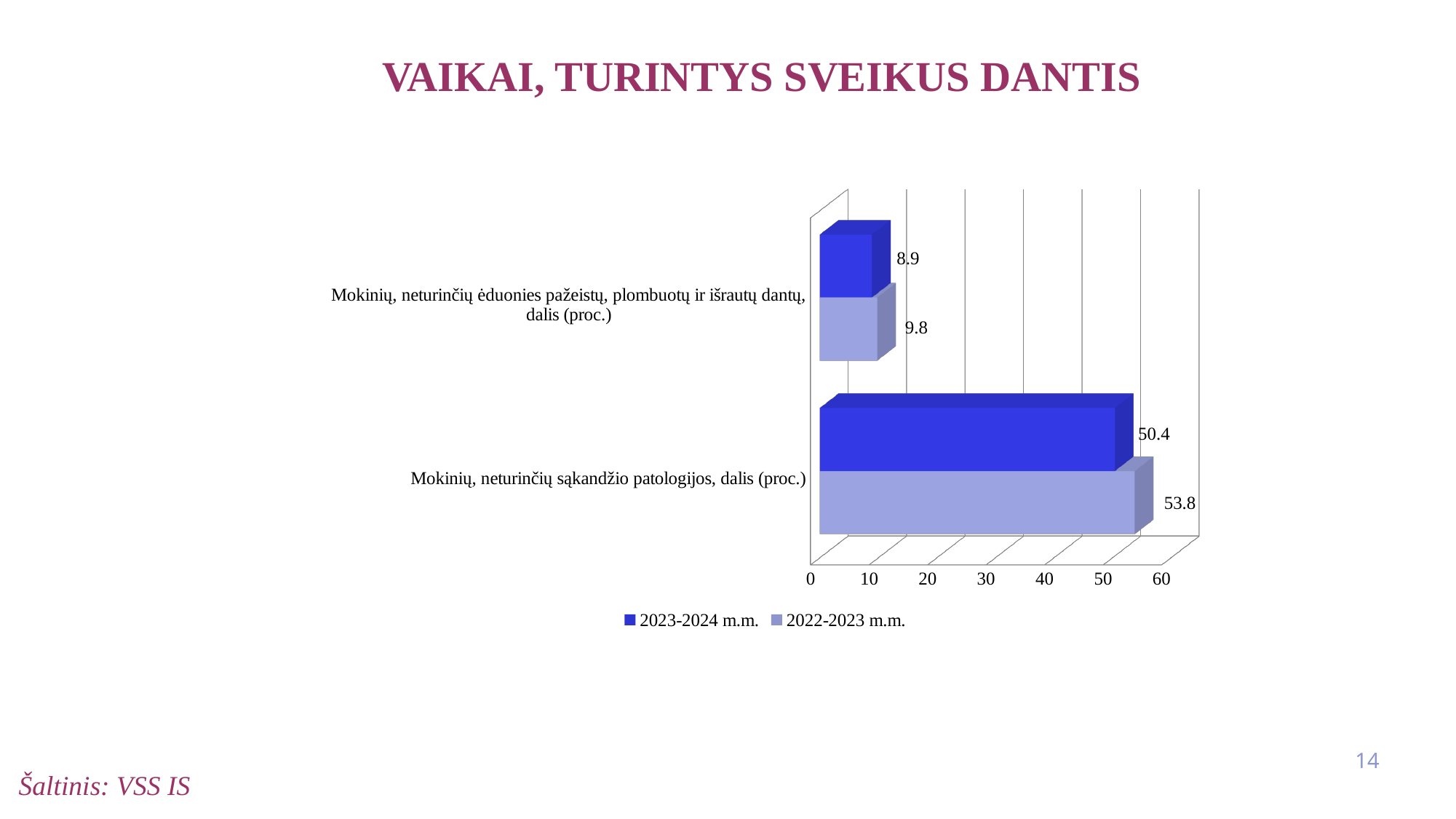
For 'Mokinių, neturinčių sąkandžio patologijos, dalis (proc.)', which series has the larger value, 2023-2024 m.m. or 2022-2023 m.m.? 2022-2023 m.m. How many series does the legend list? 2 What kind of chart is shown on the slide? Bar chart What is the value for 'Mokinių, neturinčių ėduonies pažeistų, plombuotų ir išrautų dantų, dalis (proc.)' in 2022-2023 m.m.? 9.8 Which category has the highest value in the 2022-2023 m.m. series? Mokinių, neturinčių sąkandžio patologijos, dalis (proc.) What is the value for 'Mokinių, neturinčių sąkandžio patologijos, dalis (proc.)' in 2022-2023 m.m.? 53.8 What is the value for 'Mokinių, neturinčių sąkandžio patologijos, dalis (proc.)' in 2023-2024 m.m.? 50.4 What is the difference between the 2022-2023 m.m. and 2023-2024 m.m. values for 'Mokinių, neturinčių ėduonies pažeistų, plombuotų ir išrautų dantų, dalis (proc.)'? 0.9 What is the value for 'Mokinių, neturinčių ėduonies pažeistų, plombuotų ir išrautų dantų, dalis (proc.)' in 2023-2024 m.m.? 8.9 Which category has the lowest value in the 2023-2024 m.m. series? Mokinių, neturinčių ėduonies pažeistų, plombuotų ir išrautų dantų, dalis (proc.) What is the difference between the 2022-2023 m.m. and 2023-2024 m.m. values for 'Mokinių, neturinčių sąkandžio patologijos, dalis (proc.)'? 3.4 What is the title of the chart on the slide? VAIKAI, TURINTYS SVEIKUS DANTIS